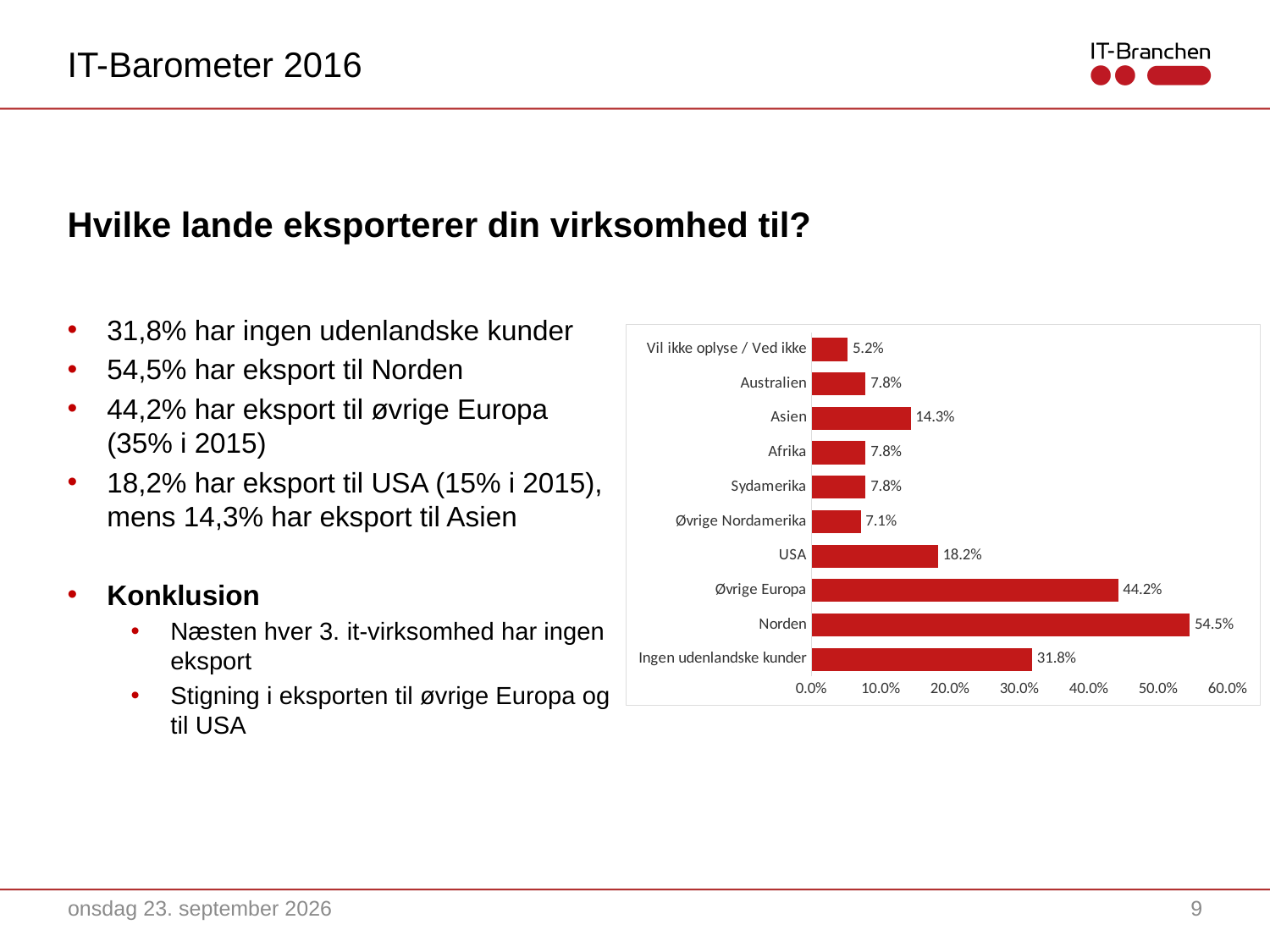
Which category has the highest value? Norden What is the value for Øvrige Nordamerika? 7.1% What colour are the bars in the chart? red What is the value for Ingen udenlandske kunder? 31.8% Is the value for Øvrige Europa greater or less than 40.0%? greater What is the difference between the values for Norden and Øvrige Europa? 10.3% Which is larger, the value for USA or the value for Asien? USA What kind of chart is shown on the slide? bar chart What is the value for Norden? 54.5% Which category has the lowest value? Vil ikke oplyse / Ved ikke What is the value for Asien? 14.3% How many categories are shown in the chart? 10